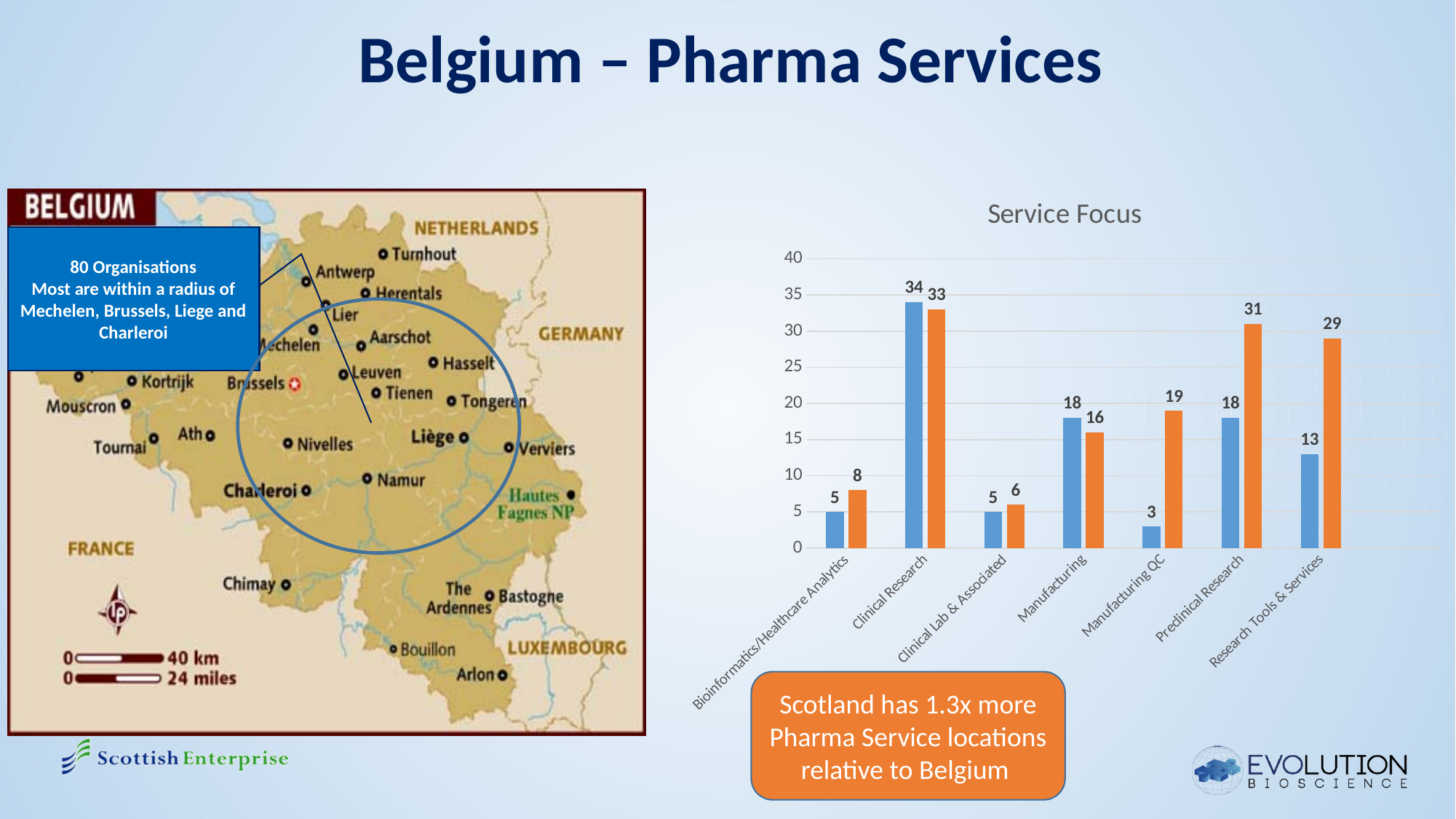
Which category has the lowest blue bar? Manufacturing QC Is the orange bar for Preclinical Research greater or less than 25? greater What is the value of the blue bar for Clinical Research? 34 What is the value of the orange bar for Preclinical Research? 31 What kind of chart is shown on the slide? bar chart What is the value of the orange bar for Research Tools & Services? 29 What is the difference between the orange and blue bars for Manufacturing QC? 16 Which category has the highest blue bar? Clinical Research What is the title of the chart on the slide? Service Focus How many categories are shown on the x axis of the Service Focus chart? 7 For Manufacturing, which bar is larger, blue or orange? blue What is the value of the blue bar for Manufacturing QC? 3